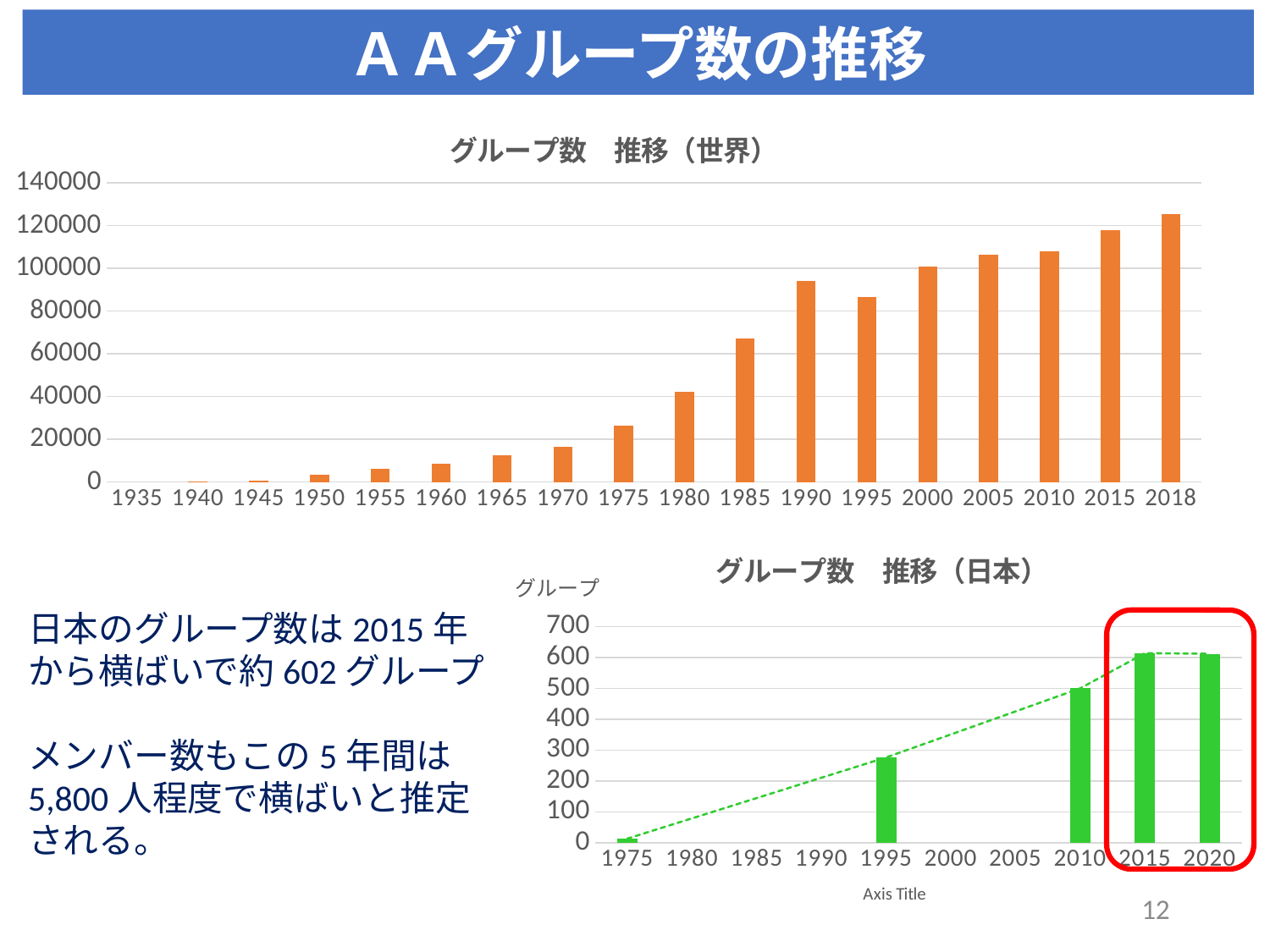
In the bottom chart titled グループ数 推移（日本）, is the value for 1995 greater or less than 300? less What is the title of the top chart on the slide? グループ数 推移（世界） In the top chart titled グループ数 推移（世界）, do the values generally rise or fall from 1935 to 2018? rise In the bottom chart titled グループ数 推移（日本）, is the value for 2015 greater or less than 500? greater In the top chart titled グループ数 推移（世界）, which year has the highest value? 2018 In the top chart titled グループ数 推移（世界）, is the value for 1990 greater or less than 80000? greater In the bottom chart titled グループ数 推移（日本）, which is larger, the value for 1995 or the value for 2010? 2010 In the top chart titled グループ数 推移（世界）, how many year categories are shown on the x axis? 18 In the top chart titled グループ数 推移（世界）, what kind of chart is it? bar chart In the top chart titled グループ数 推移（世界）, which is larger, the value for 1990 or the value for 1995? 1990